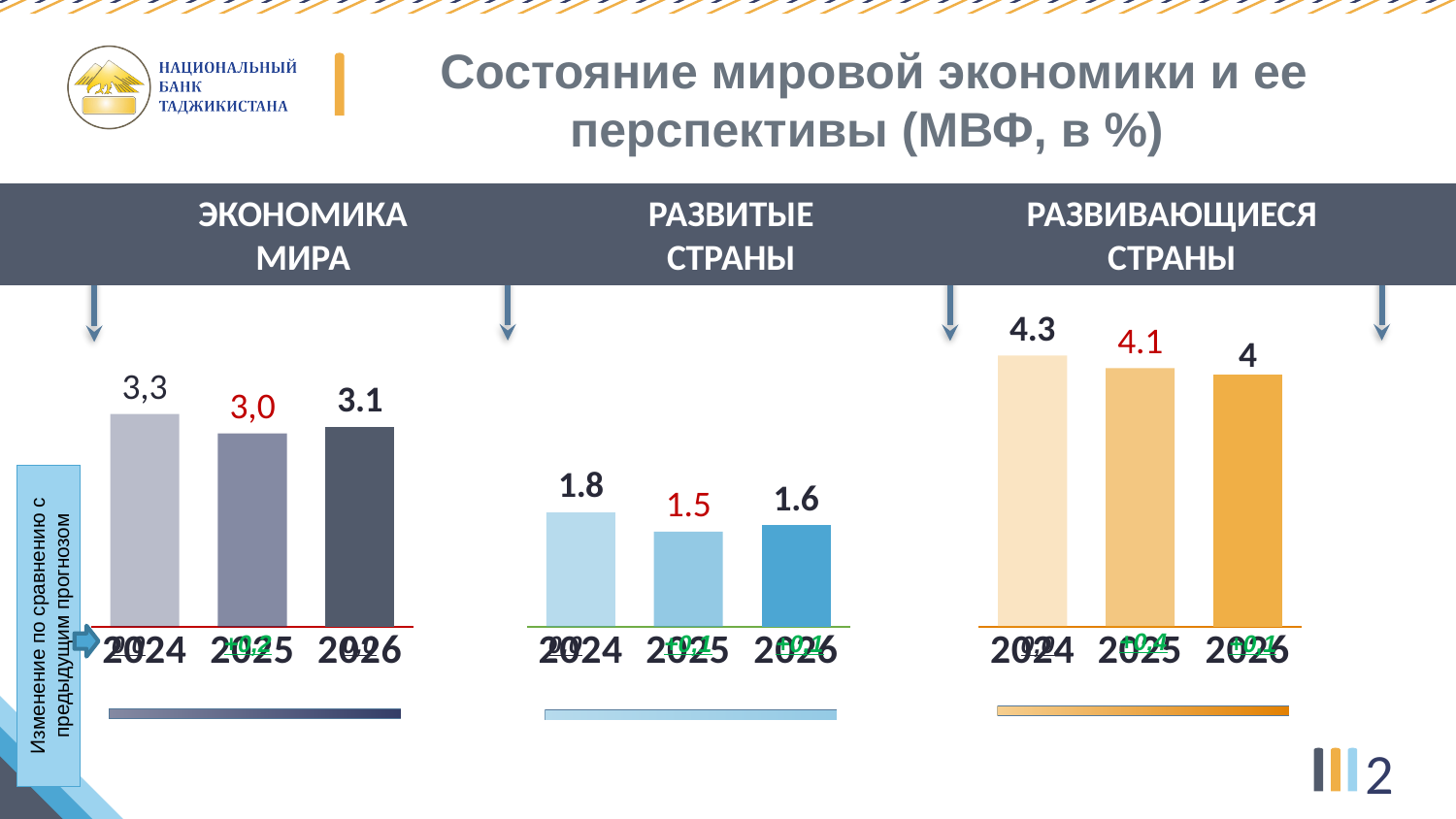
In the ЭКОНОМИКА МИРА chart, which is larger, the value for 2024 or the value for 2026? 2024 In the ЭКОНОМИКА МИРА chart, what is the value for 2025? 3,0 In the РАЗВИВАЮЩИЕСЯ СТРАНЫ chart, which year has the highest value? 2024 In the РАЗВИВАЮЩИЕСЯ СТРАНЫ chart, what is the value for 2024? 4.3 In the ЭКОНОМИКА МИРА chart, what is the value for 2024? 3,3 In the РАЗВИТЫЕ СТРАНЫ chart, what is the value for 2026? 1.6 How many bars does the РАЗВИТЫЕ СТРАНЫ chart have? 3 What type of chart is the ЭКОНОМИКА МИРА chart? Bar chart In the РАЗВИТЫЕ СТРАНЫ chart, which year has the lowest value? 2025 In the РАЗВИВАЮЩИЕСЯ СТРАНЫ chart, what is the value for 2026? 4 In the РАЗВИВАЮЩИЕСЯ СТРАНЫ chart, what is the difference between the 2024 and 2026 values? 0.3 In the РАЗВИТЫЕ СТРАНЫ chart, what is the difference between the 2024 and 2025 values? 0.3